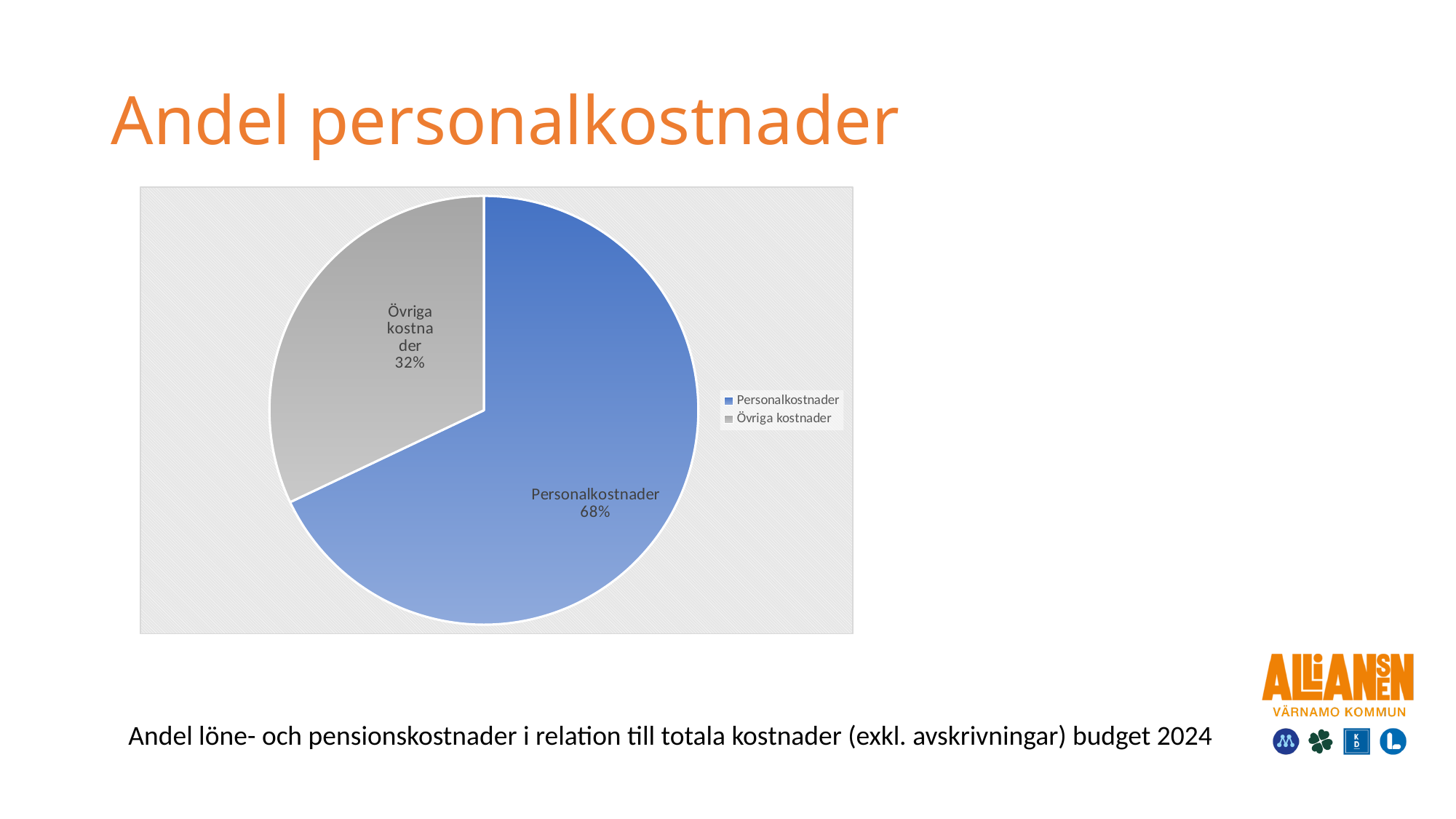
How many entries does the legend list? 2 What kind of chart is shown on the slide? pie chart Which slice of the pie is the largest? Personalkostnader What share of the pie does Övriga kostnader represent? 32% Which is larger, Personalkostnader or Övriga kostnader? Personalkostnader What is the title of the slide containing the pie chart? Andel personalkostnader What is the difference in percentage points between Personalkostnader and Övriga kostnader? 36 What colour is the Personalkostnader slice? blue How many slices does the pie chart have? 2 Which slice of the pie is the smallest? Övriga kostnader What share of the pie does Personalkostnader represent? 68%